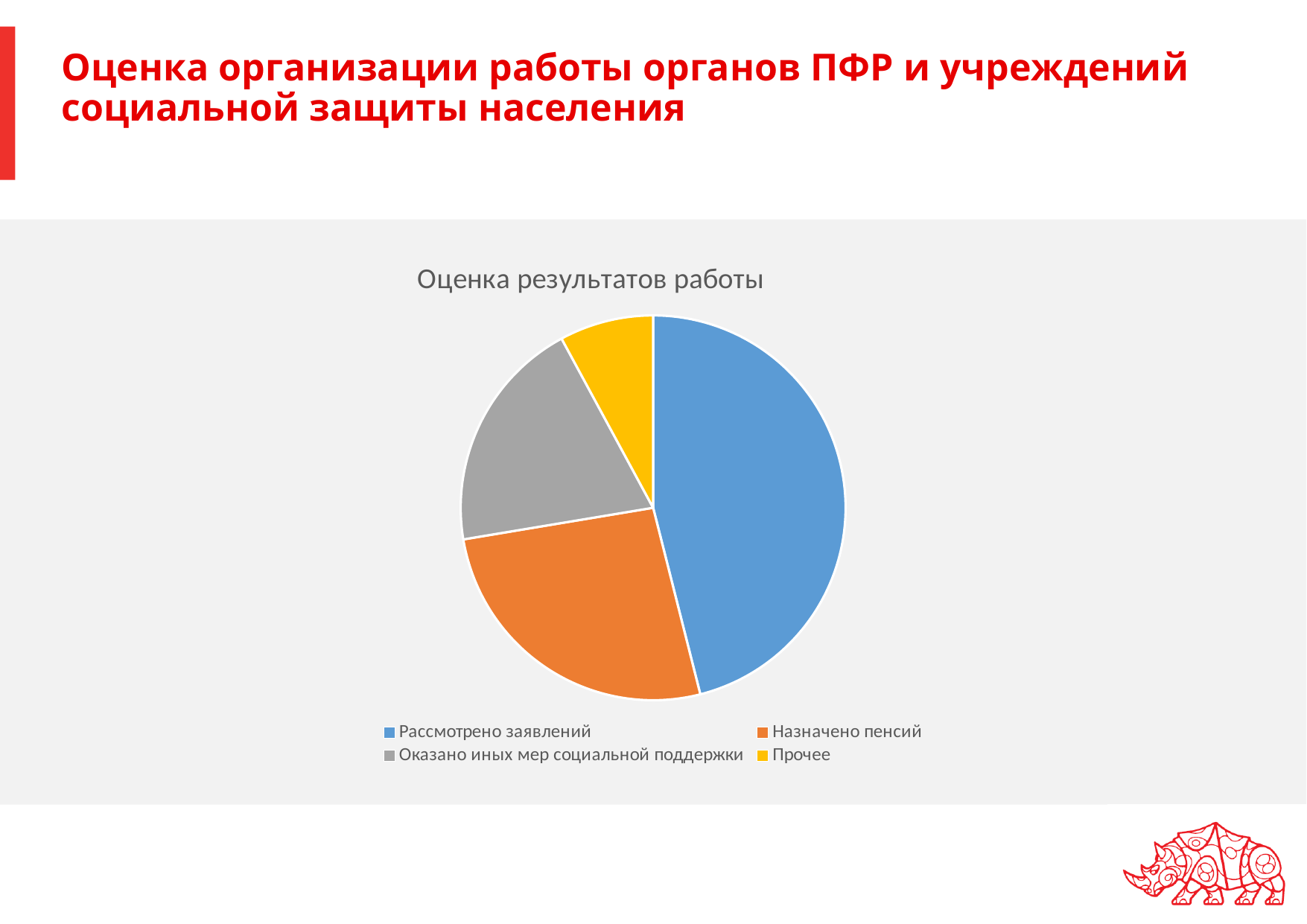
How many slices does the pie chart have? 4 Which slice is larger: Назначено пенсий or Оказано иных мер социальной поддержки? Назначено пенсий What is the title of the chart? Оценка результатов работы What kind of chart is shown on the slide? pie chart Which category has the largest slice of the pie? Рассмотрено заявлений What colour is the slice for Прочее? yellow Which slice is larger: Рассмотрено заявлений or Назначено пенсий? Рассмотрено заявлений Which slice is larger: Прочее or Оказано иных мер социальной поддержки? Оказано иных мер социальной поддержки How many entries does the legend list? 4 Which category has the smallest slice of the pie? Прочее